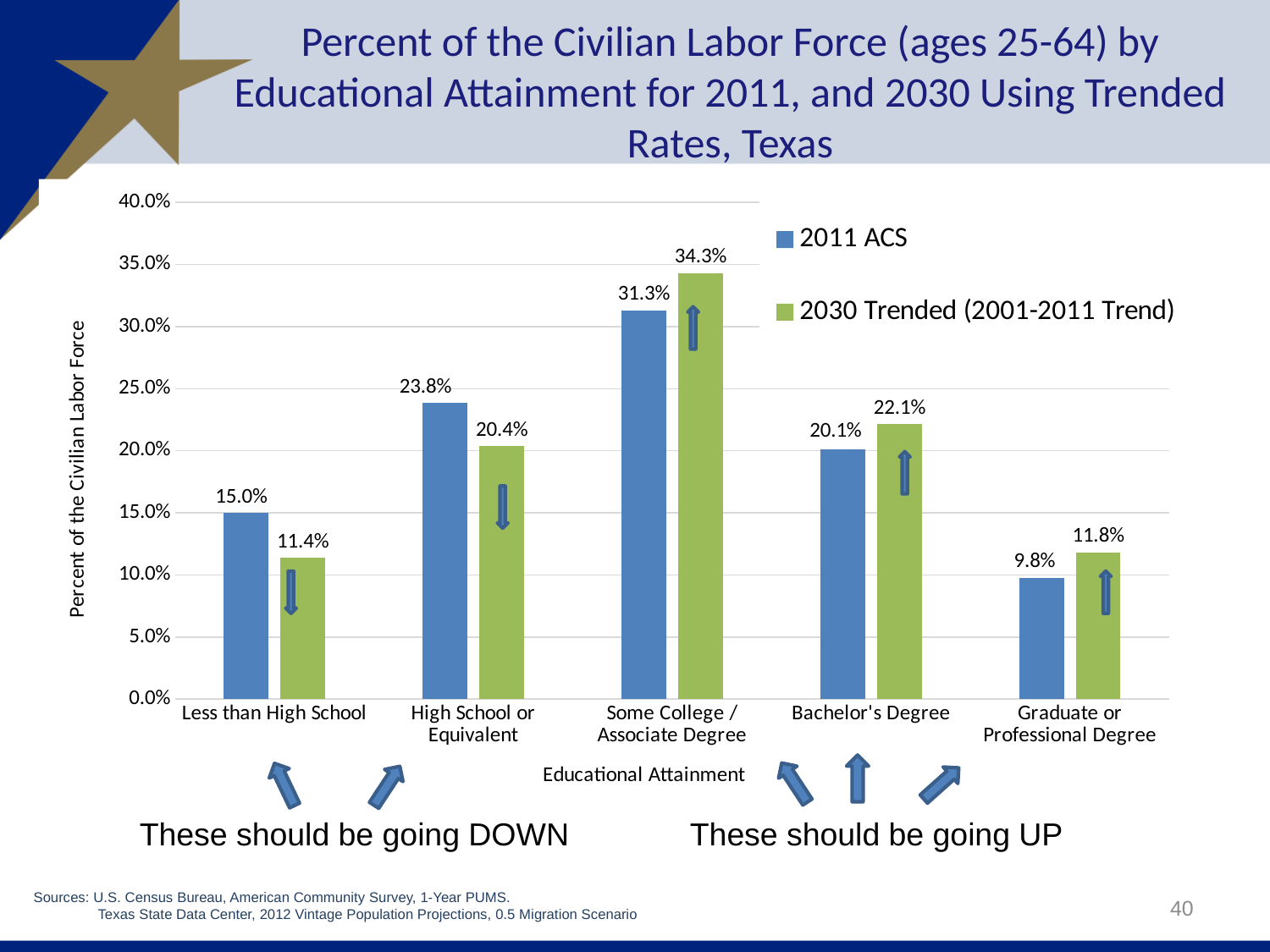
What is the 2030 Trended value for Graduate or Professional Degree? 11.8% What is the 2030 Trended (2001-2011 Trend) value for Less than High School? 11.4% What is the difference between the 2011 ACS and 2030 Trended values for High School or Equivalent? 3.4% What kind of chart is shown on the slide? Bar chart What is the 2011 ACS value for Some College / Associate Degree? 31.3% For Less than High School, which is larger: the 2011 ACS value or the 2030 Trended value? 2011 ACS Which educational attainment category has the lowest 2011 ACS value? Graduate or Professional Degree How many educational attainment categories are shown on the x axis? 5 Which educational attainment category has the highest 2030 Trended value? Some College / Associate Degree How many series does the legend list? 2 What is the difference between the 2030 Trended and 2011 ACS values for Bachelor's Degree? 2.0% Is the 2011 ACS value for High School or Equivalent greater or less than 20.0%? greater